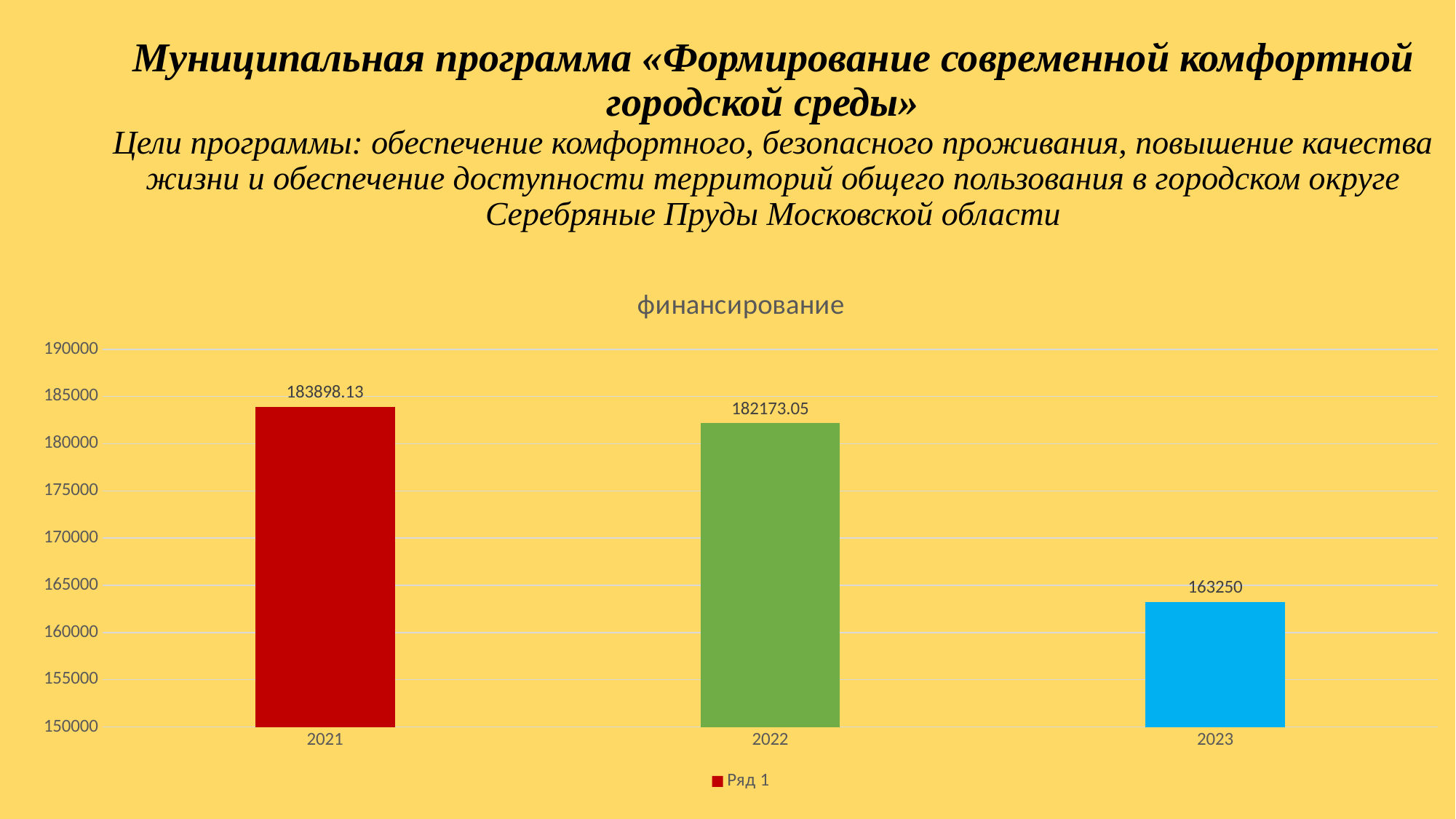
Which year has the lowest value? 2023 Do the values rise or fall from 2021 to 2023? fall Which is larger, the value for 2022 or the value for 2023? 2022 Which year has the highest value? 2021 How many years are shown on the chart? 3 Is the value for 2023 greater or less than 165000? less What is the value for 2022? 182173.05 What is the value for 2021? 183898.13 What kind of chart is shown? bar chart What is the value for 2023? 163250 What is the difference between the values for 2021 and 2023? 20648.13 What is the difference between the values for 2022 and 2023? 18923.05